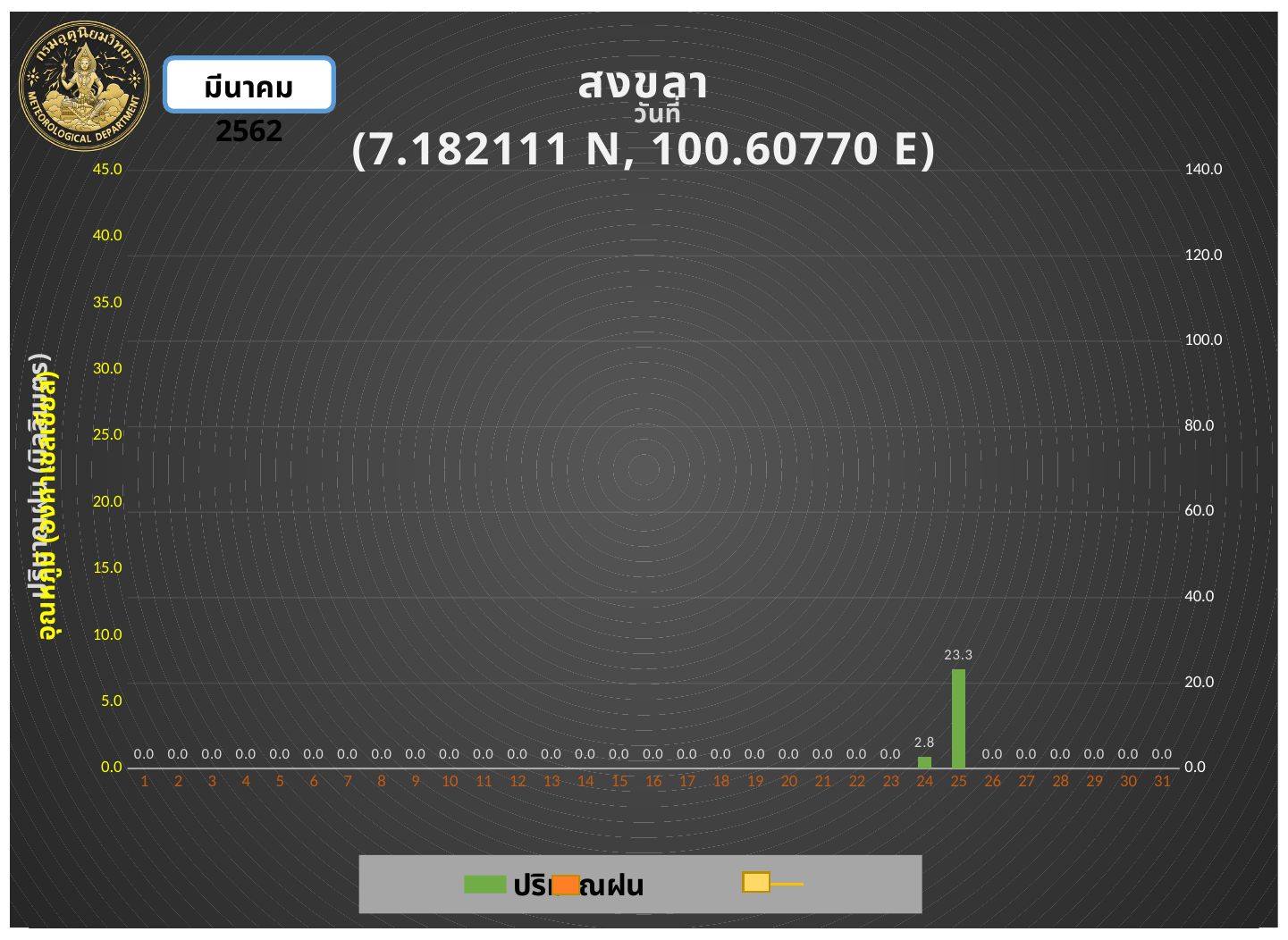
How many days are shown on the x axis? 31 Which is larger, the value for day 24 or the value for day 25? day 25 Is the value for day 25 greater or less than 20.0? greater What is the value for day 25? 23.3 What is the highest tick value on the right vertical axis? 140.0 What is the highest tick value on the left vertical axis? 45.0 What is the value for day 24? 2.8 What is the difference between the values for day 25 and day 24? 20.5 What kind of chart is this? bar chart How many days have a value greater than 0.0? 2 Which day has the highest value? 25 What is the value for day 10? 0.0